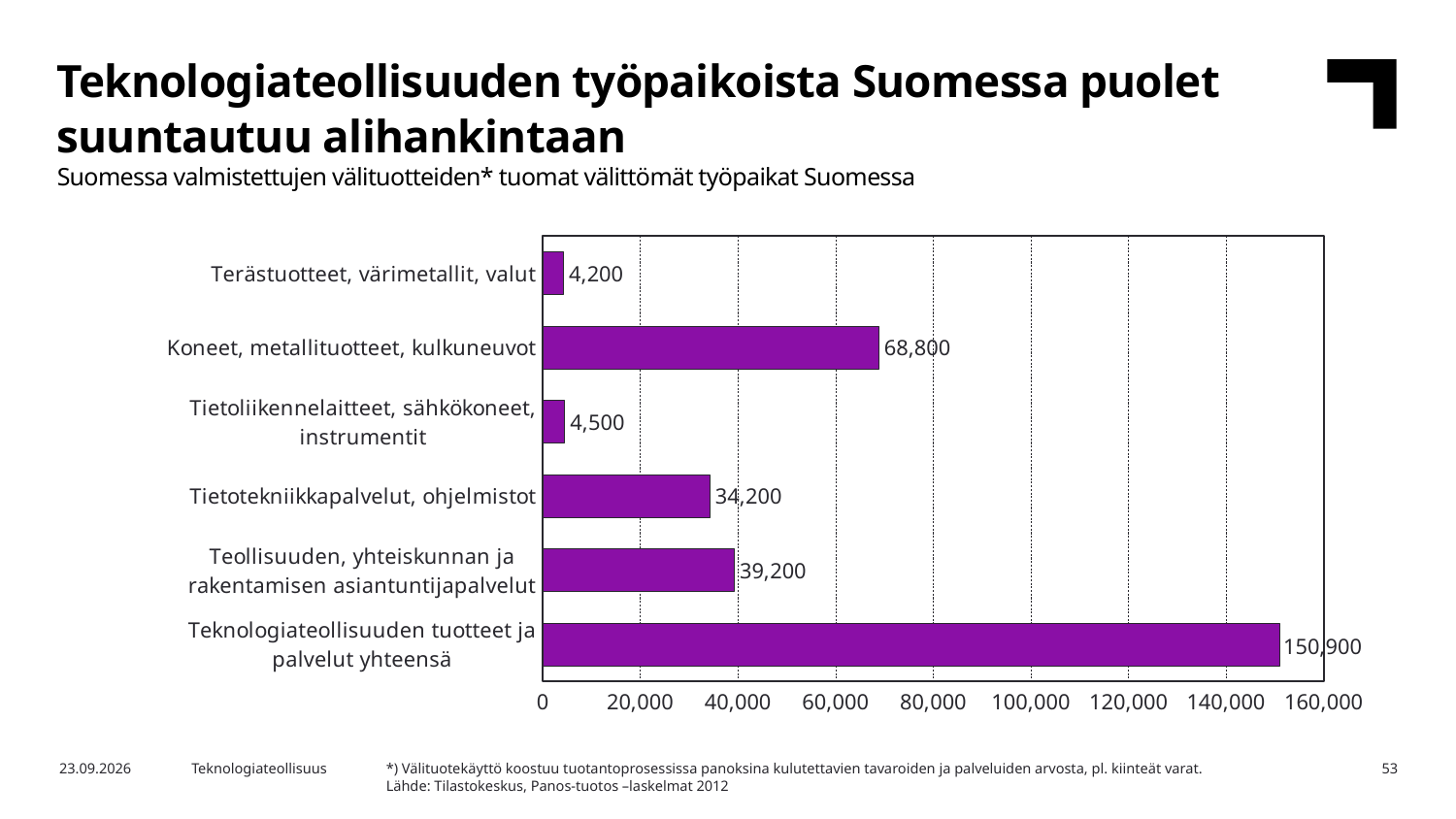
What is the difference between Teollisuuden, yhteiskunnan ja rakentamisen asiantuntijapalvelut and Tietotekniikkapalvelut, ohjelmistot? 5,000 Is the value for Koneet, metallituotteet, kulkuneuvot greater or less than 60,000? greater What is the value for Tietoliikennelaitteet, sähkökoneet, instrumentit? 4,500 What is the value for Teknologiateollisuuden tuotteet ja palvelut yhteensä? 150,900 What is the value for Koneet, metallituotteet, kulkuneuvot? 68,800 Which category has the lowest value? Terästuotteet, värimetallit, valut What is the value for Tietotekniikkapalvelut, ohjelmistot? 34,200 What kind of chart is shown on the slide? bar chart What is the difference between Koneet, metallituotteet, kulkuneuvot and Tietotekniikkapalvelut, ohjelmistot? 34,600 Which category has the highest value? Teknologiateollisuuden tuotteet ja palvelut yhteensä How many categories are shown in the chart? 6 Which is larger: Teollisuuden, yhteiskunnan ja rakentamisen asiantuntijapalvelut or Tietotekniikkapalvelut, ohjelmistot? Teollisuuden, yhteiskunnan ja rakentamisen asiantuntijapalvelut